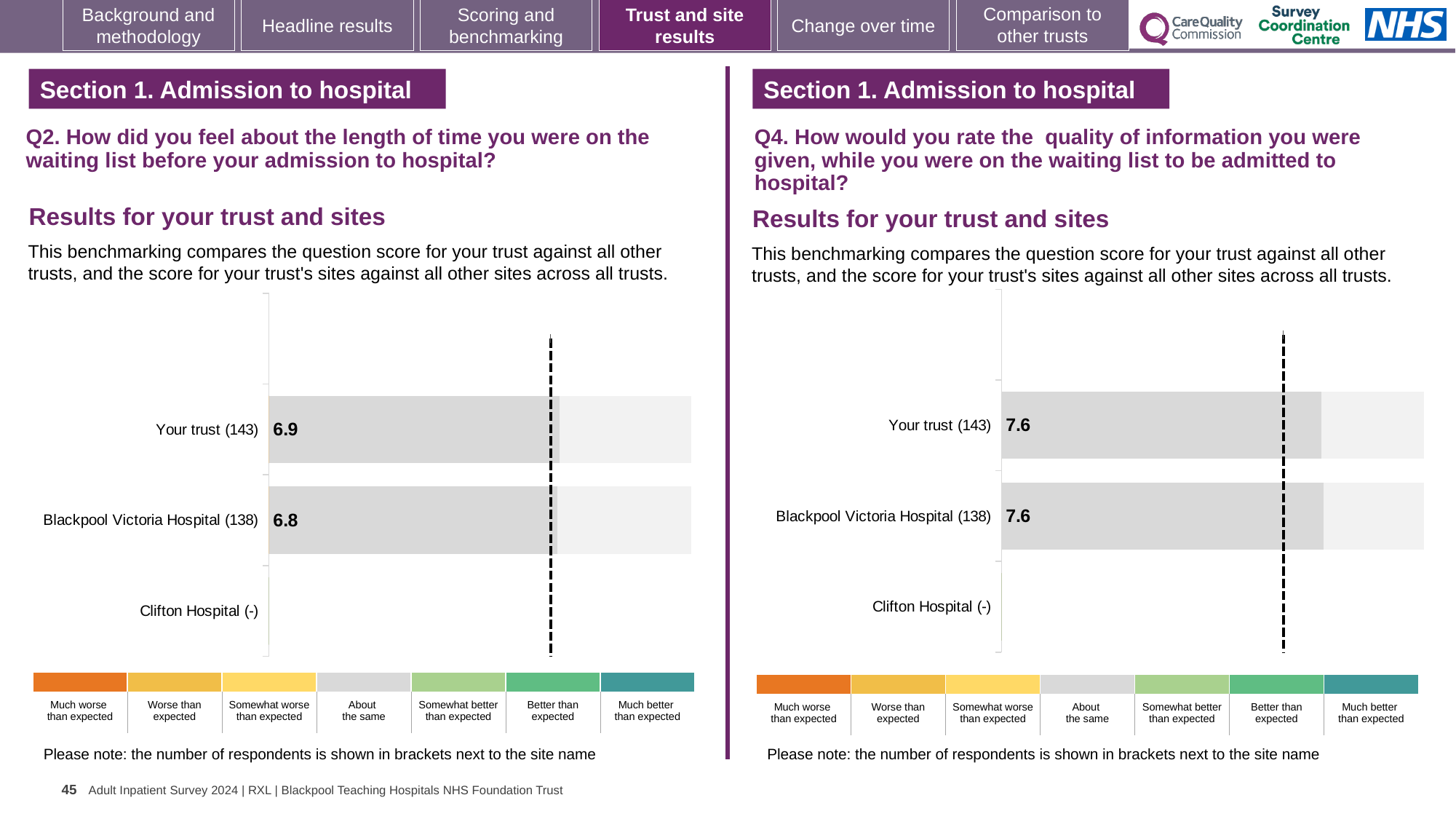
On the left chart (Q2), how many respondents are shown in brackets for Blackpool Victoria Hospital? 138 On the left chart (Q2), what is the difference between the score for Your trust and the score for Blackpool Victoria Hospital? 0.1 On the left chart (Q2), which category has the lowest printed score? Blackpool Victoria Hospital On the left chart (Q2), which has the higher score, Your trust or Blackpool Victoria Hospital? Your trust How many site/trust categories are listed on the left chart (Q2)? 3 What type of chart is used on the right (Q4)? Bar chart On the right chart (Q4), what is the score for Your trust? 7.6 On the left chart (Q2), what is the score for Your trust? 6.9 On the right chart (Q4), how many respondents are shown in brackets for Your trust? 143 On the right chart (Q4), what is the score for Blackpool Victoria Hospital? 7.6 On the left chart (Q2), what is the score for Blackpool Victoria Hospital? 6.8 On the right chart (Q4), what is the difference between the score for Your trust and the score for Blackpool Victoria Hospital? 0